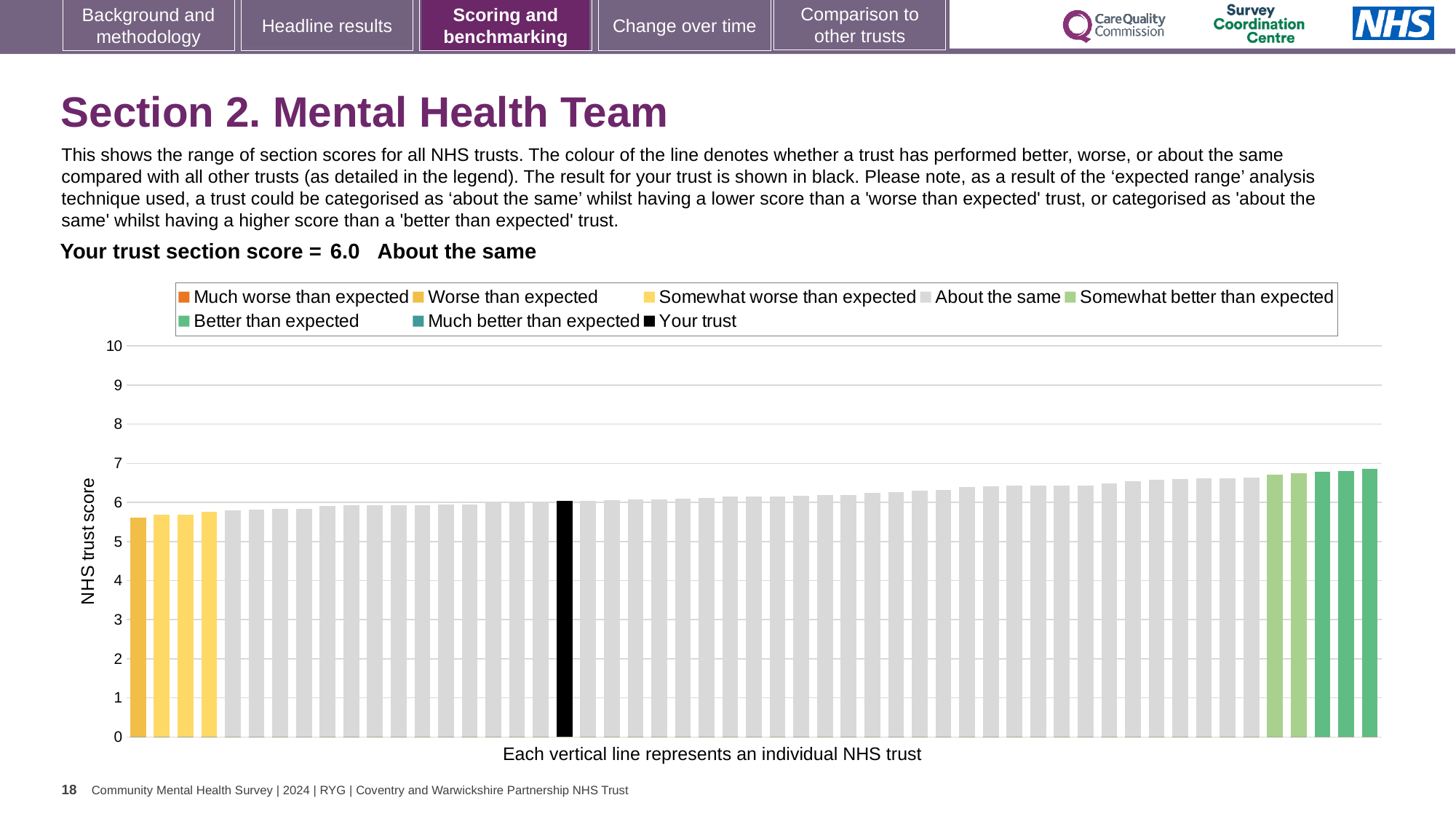
How many entries does the chart legend list? 8 Which category is your trust placed in for this section? About the same Is the value of the black 'Your trust' bar greater or less than 5? greater Is the value of the black 'Your trust' bar greater or less than 7? less What is the section score for your trust shown on the slide? 6.0 Is the value of the shortest bar greater or less than 5? greater What kind of chart is shown on the slide? bar chart What is the label on the vertical axis of the chart? NHS trust score How many bars in the chart are coloured black? 1 Do the bar values rise or fall from left to right along the x axis? rise